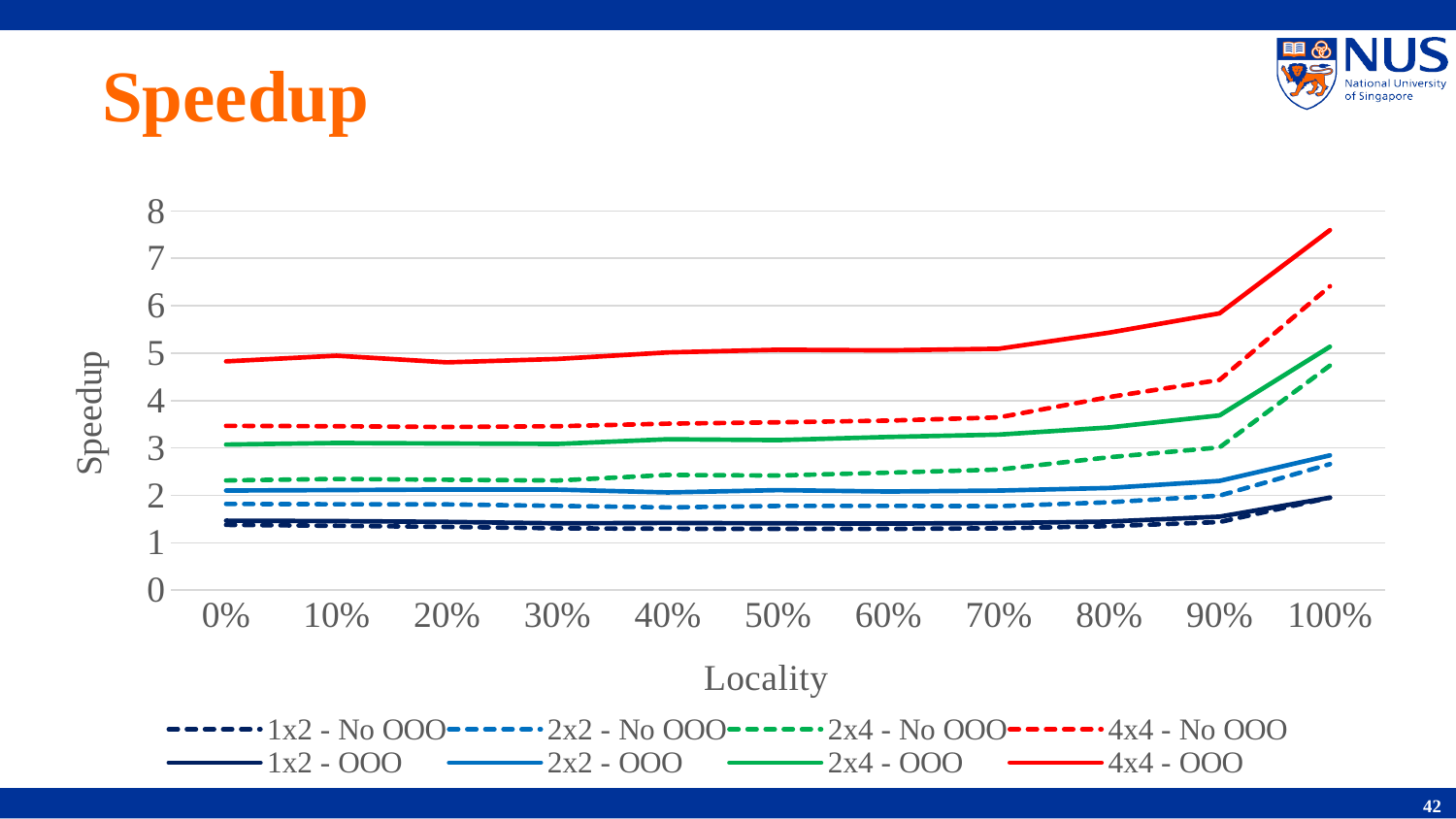
What kind of chart is shown on the slide? line chart Is the value for 4x4 - OOO at 0% locality greater or less than 4? greater Which series has the highest speedup at 100% locality? 4x4 - OOO At 100% locality, which is larger: 4x4 - No OOO or 2x4 - OOO? 4x4 - No OOO Does the speedup for 4x4 - OOO rise or fall as locality increases from 0% to 100%? rise Is the value for 2x4 - OOO at 100% locality greater or less than 4? greater How many locality values are plotted along the x axis? 11 Is the value for 4x4 - OOO at 100% locality greater or less than 7? greater How many series does the legend list? 8 What is the label of the x axis? Locality